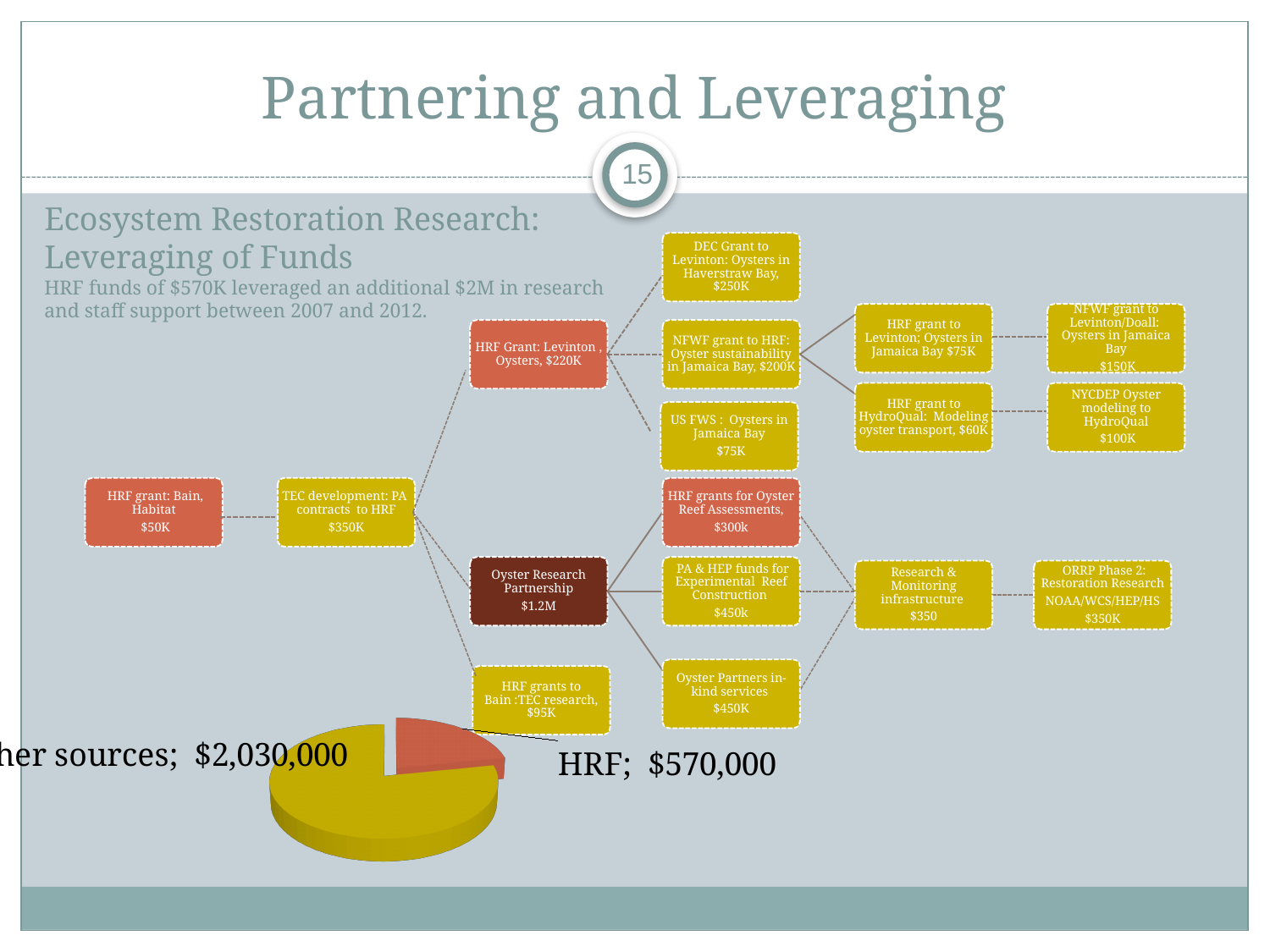
How many slices does the pie chart have? 2 Which slice of the pie chart is the smallest? HRF What colour is the HRF slice in the pie chart? red What is the difference between the two values shown in the pie chart, $2,030,000 and $570,000? $1,460,000 In the pie chart, is the HRF slice larger or smaller than the yellow slice? smaller What colour is the larger slice in the pie chart? yellow In the pie chart, what is the value shown for the large yellow slice (other sources)? $2,030,000 What kind of chart is shown at the bottom of the slide? pie chart In the pie chart, what is the value shown for HRF? $570,000 What share of the pie chart total does the $2,030,000 slice represent? 78.1% What share of the pie chart total does the HRF slice ($570,000) represent? 21.9% What is the total of the two values shown in the pie chart? $2,600,000